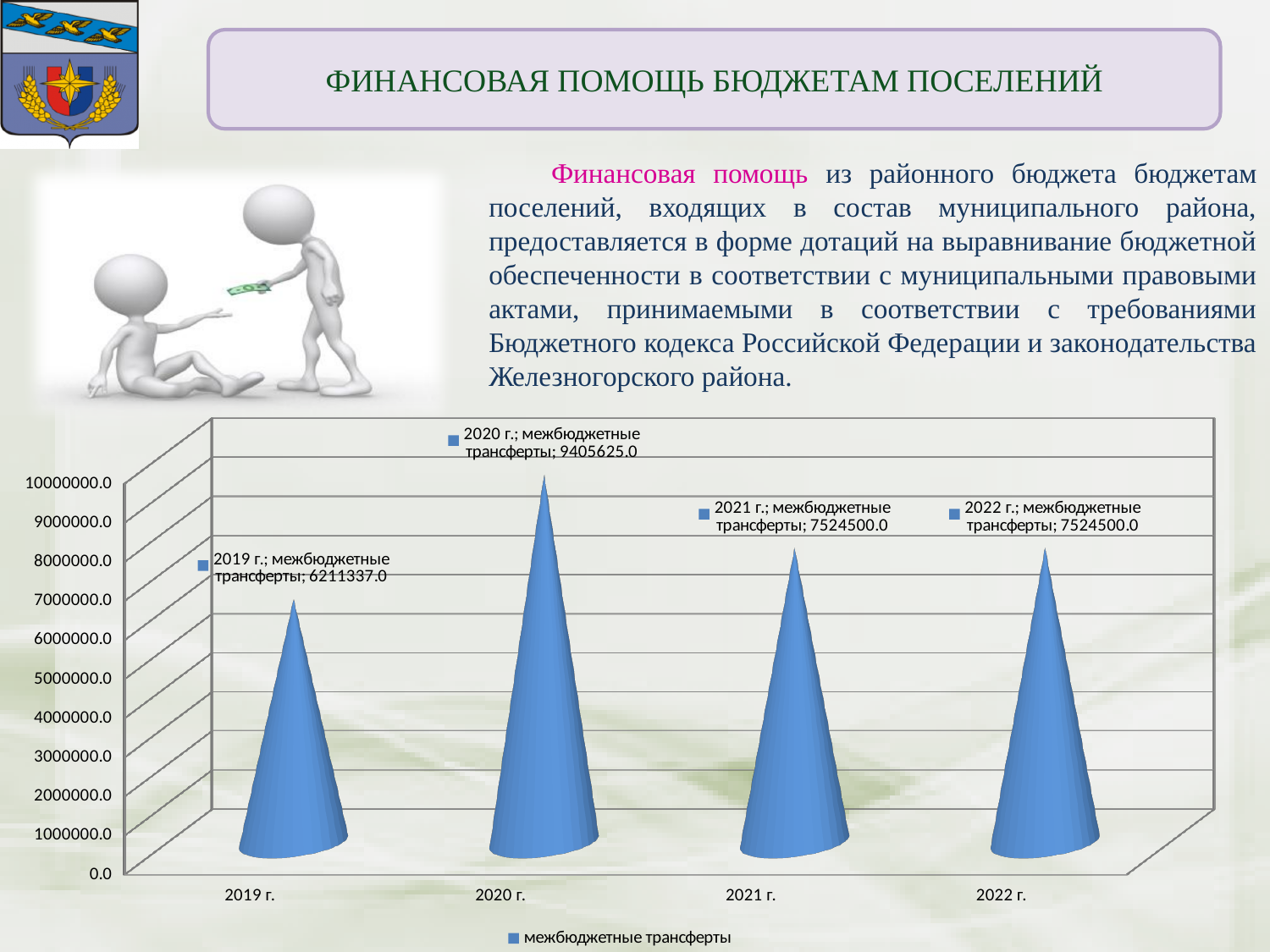
Which year has the lowest value of межбюджетные трансферты? 2019 г. What kind of chart is shown on the slide? bar chart What is the value of межбюджетные трансферты for 2019 г.? 6211337.0 What is the value of межбюджетные трансферты for 2021 г.? 7524500.0 What is the difference between the values for 2020 г. and 2019 г.? 3194288.0 Which is larger, the value for 2019 г. or the value for 2021 г.? 2021 г. Which year has the highest value of межбюджетные трансферты? 2020 г. How many series does the chart legend list? 1 What is the difference between the values for 2020 г. and 2021 г.? 1881125.0 What is the value of межбюджетные трансферты for 2022 г.? 7524500.0 How many years are shown on the x axis of the chart? 4 What is the value of межбюджетные трансферты for 2020 г.? 9405625.0